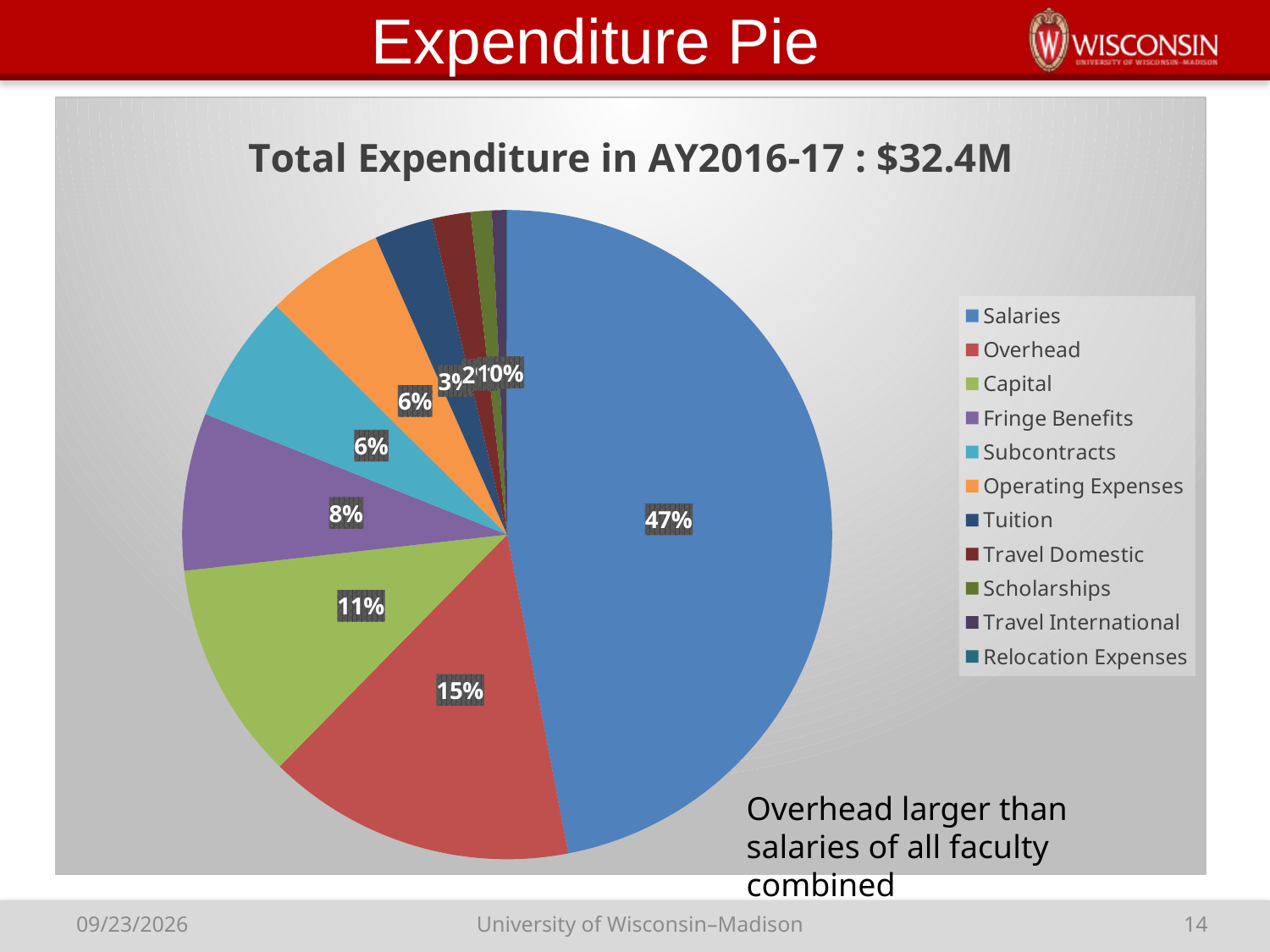
What total expenditure amount is stated in the chart title? $32.4M How many categories are listed in the chart's legend? 11 What percentage is shown for Subcontracts? 6% Which slice is larger, Overhead or Capital? Overhead What percentage is shown for Capital? 11% What kind of chart is shown on the slide? Pie chart How many percentage points larger is the Salaries slice than the Overhead slice? 32 What percentage is shown for Overhead? 15% Which slice is larger, Capital or Fringe Benefits? Capital What percentage is shown for Fringe Benefits? 8% What share of the pie does Salaries account for? 47% Which category has the largest slice of the pie? Salaries